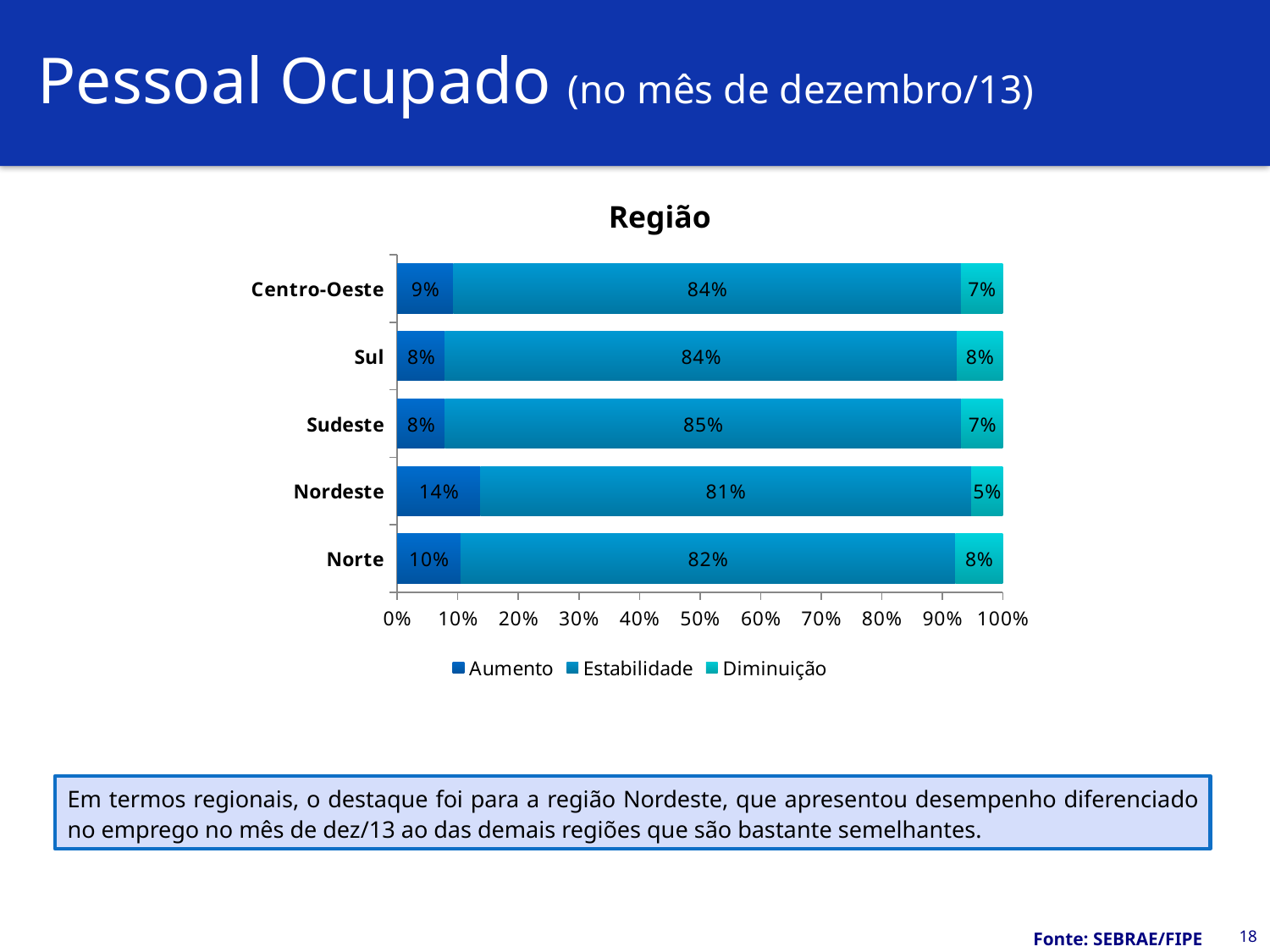
What is the difference between the Aumento values for Nordeste and Sul? 6% Which region has the highest Aumento value? Nordeste What is the Aumento value for Centro-Oeste? 9% What is the Estabilidade value for Sudeste? 85% What is the Aumento value for Nordeste? 14% How many regions are shown on the chart? 5 What kind of chart is shown on the slide? Stacked bar chart Which region has the lowest Diminuição value? Nordeste How many series does the legend list? 3 Which is larger, the Estabilidade value for Sudeste or for Norte? Sudeste What is the Diminuição value for Norte? 8% Which region has the lowest Estabilidade value? Nordeste